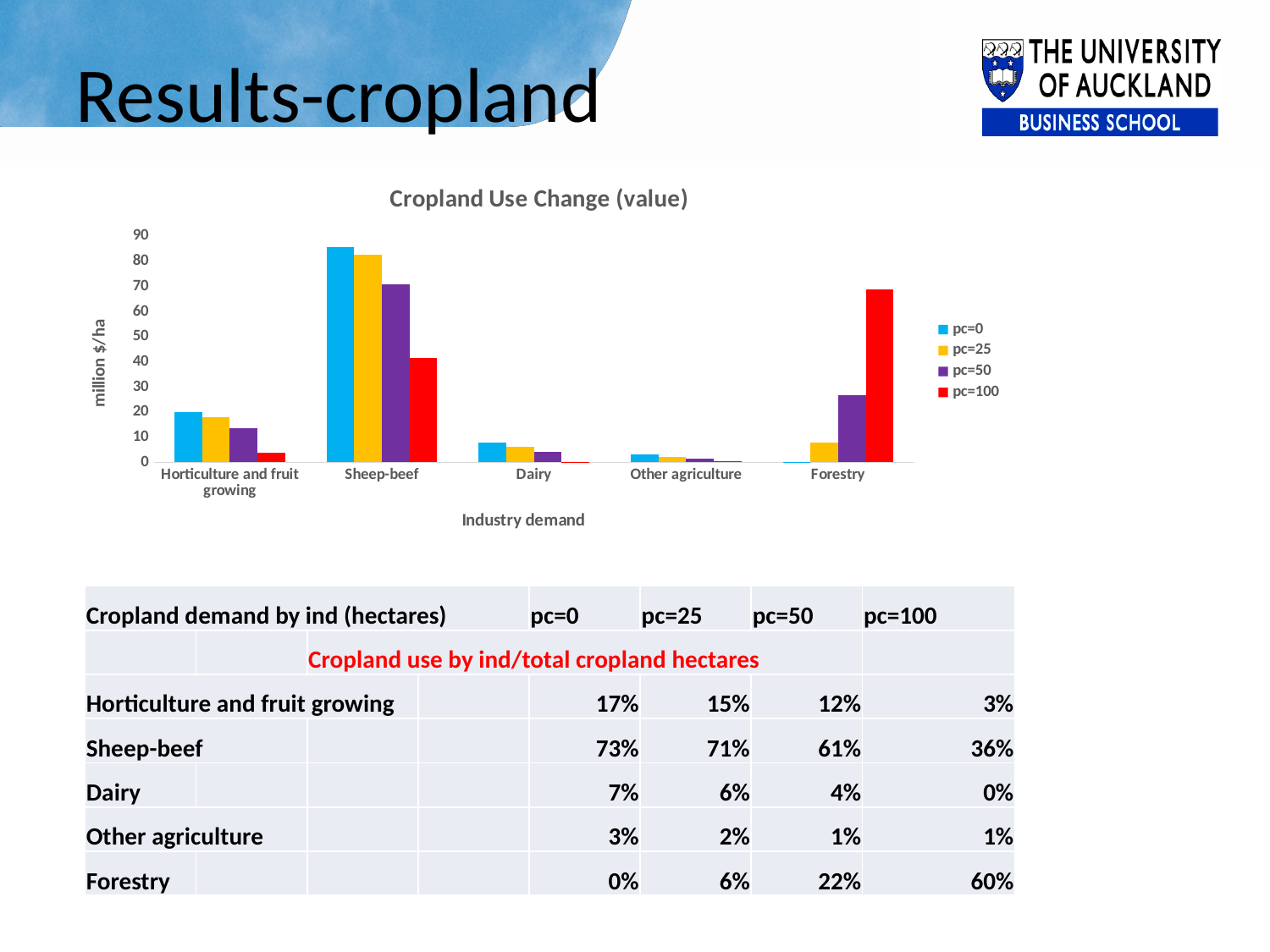
How many industry categories are shown on the x axis of the chart? 5 Which industry has the highest pc=0 bar in the chart? Sheep-beef For Forestry, which series has the tallest bar? pc=100 Is the pc=100 value for Forestry greater or less than 60? greater What is the title of the chart's vertical axis? million $/ha Is the pc=50 value for Forestry greater or less than 20? greater For Sheep-beef, do the bars rise or fall as pc increases from pc=0 to pc=100? fall What type of chart is shown on the slide? bar chart How many series does the chart legend list? 4 Is the pc=100 value for Sheep-beef greater or less than 50? less Which is larger: the pc=0 bar for Sheep-beef or the pc=100 bar for Forestry? pc=0 bar for Sheep-beef